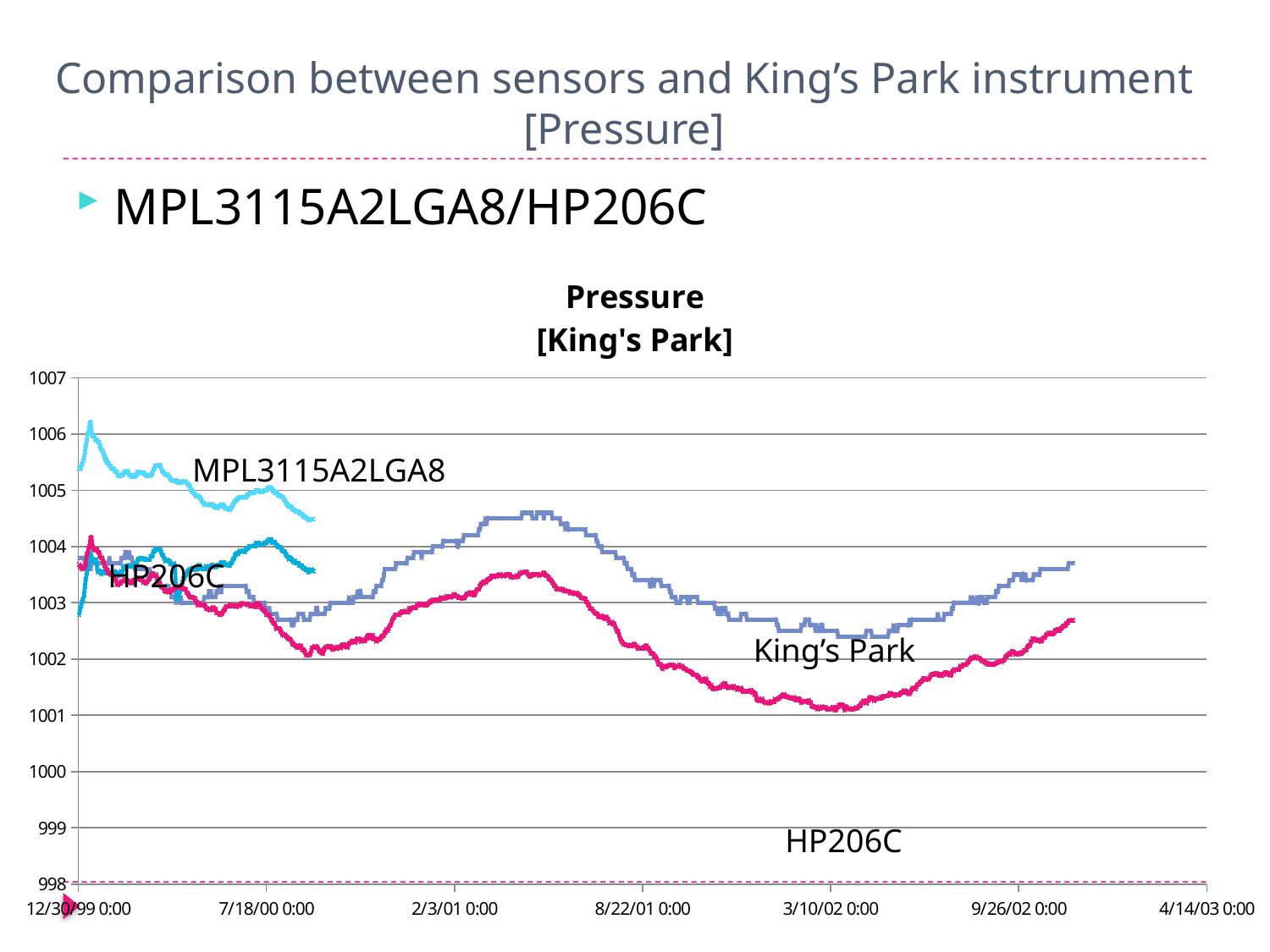
At 3/10/02 0:00, which series is higher, HP206C or King's Park? HP206C Is the highest value of the HP206C series greater or less than 1004? greater Which series reaches the lowest pressure value on the chart? King's Park What is the lowest value shown on the vertical axis? 998 Is the lowest value of the MPL3115A2LGA8 series greater or less than 1004? greater Which series reaches the highest pressure value on the chart? MPL3115A2LGA8 What is the title of the chart? Pressure [King's Park] At 7/18/00 0:00, which series is higher, MPL3115A2LGA8 or King's Park? MPL3115A2LGA8 Does the King's Park series rise or fall between 8/22/01 0:00 and 3/10/02 0:00? fall Is the lowest value of the King's Park series greater or less than 1002? less What kind of chart is shown on the slide? line chart